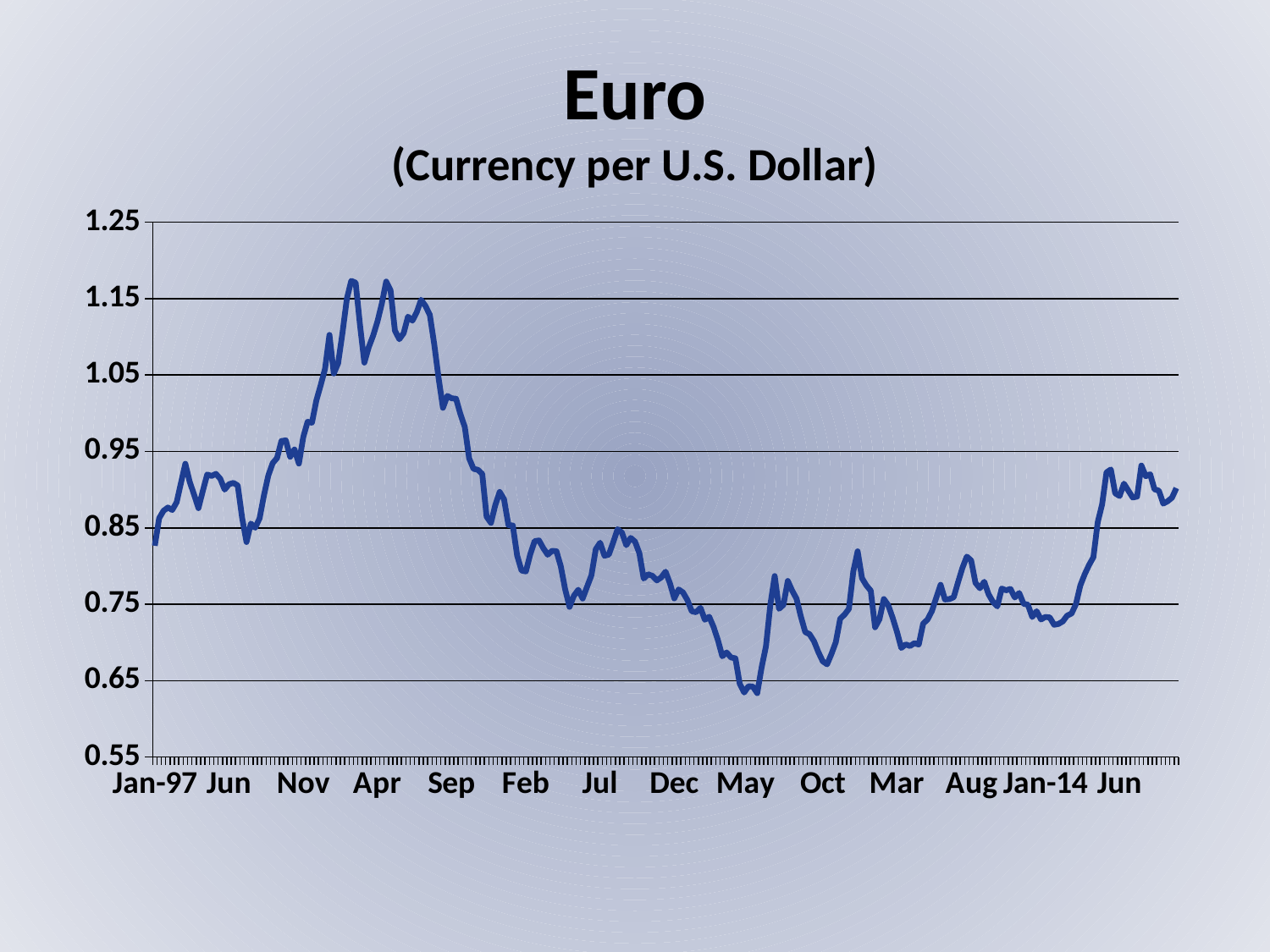
Is the value at Jan-14 greater or less than 0.85? less Is the value around Feb greater or less than 0.95? less Does the line rise or fall between Apr and May? fall What is the title of the chart? Euro (Currency per U.S. Dollar) What kind of chart is shown on the slide? line chart Is the value around May (the trough region) greater or less than 0.75? less Near which x-axis label does the line reach its highest value? Apr Does the line rise or fall between Jan-14 and Jun? rise What colour is the plotted line? blue Near which x-axis label does the line reach its lowest value? May